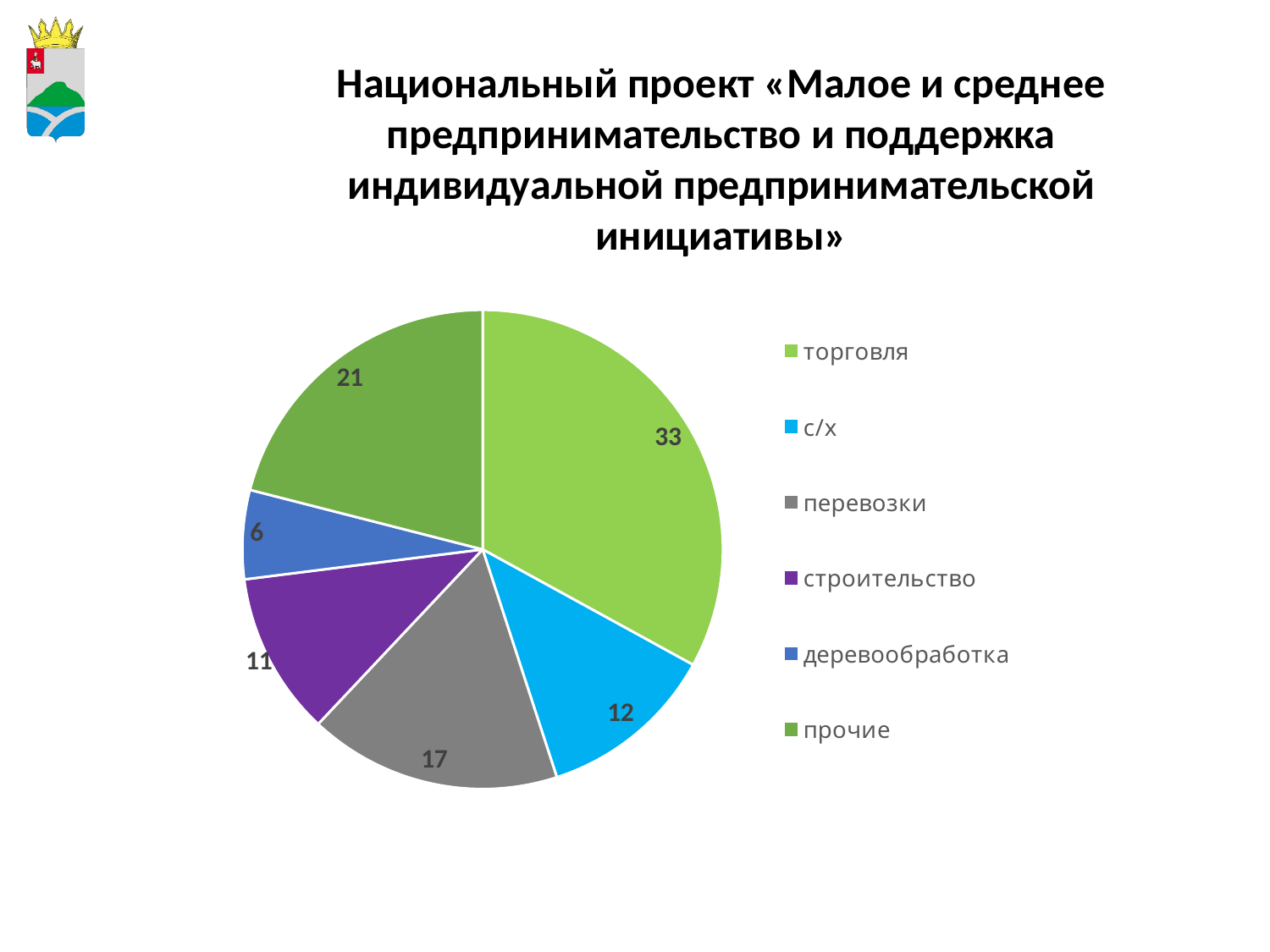
How many categories does the pie chart have? 6 What is the difference between the values for торговля and прочие? 12 What is the value for прочие? 21 What share of the pie does торговля represent? 33% What is the value for торговля? 33 Which category has the smallest slice? деревообработка What kind of chart is shown on the slide? pie chart What is the value for деревообработка? 6 What is the value for перевозки? 17 Which is larger, the value for с/х or the value for строительство? с/х What is the total of all slices in the pie chart? 100 Which category has the largest slice? торговля